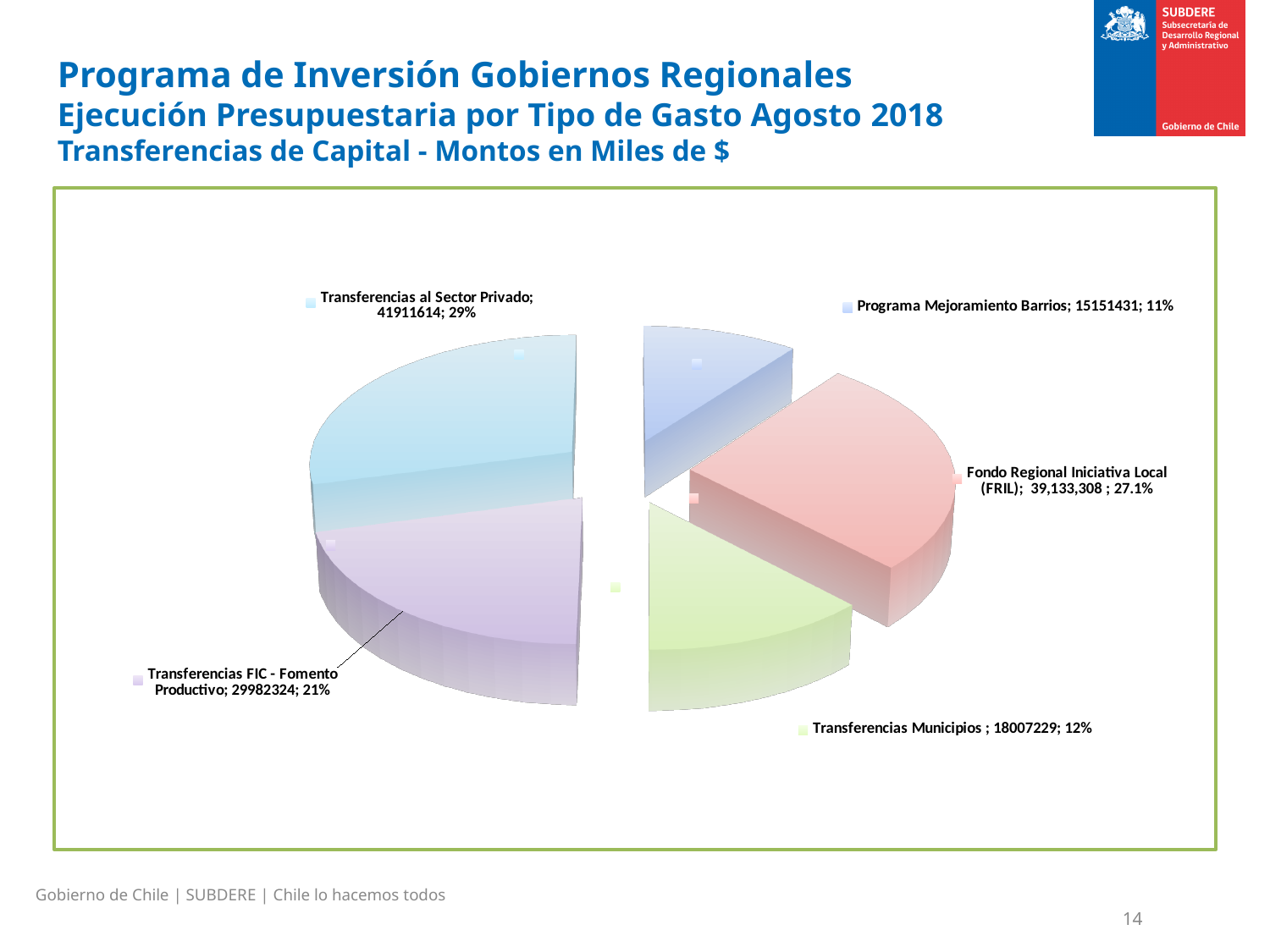
Which is larger, the value for Transferencias FIC - Fomento Productivo or the value for Transferencias Municipios? Transferencias FIC - Fomento Productivo What is the value shown for Transferencias al Sector Privado? 41911614 What is the value shown for Transferencias Municipios? 18007229 What is the difference in value between Transferencias Municipios and Programa Mejoramiento Barrios? 2855798 What percentage share does Transferencias FIC - Fomento Productivo have in the pie chart? 21% Which category has the largest slice of the pie chart? Transferencias al Sector Privado What kind of chart is shown on the slide? Pie chart What is the value shown for Fondo Regional Iniciativa Local (FRIL)? 39,133,308 Which category has the smallest slice of the pie chart? Programa Mejoramiento Barrios What percentage share does Fondo Regional Iniciativa Local (FRIL) have in the pie chart? 27.1% What percentage share does Programa Mejoramiento Barrios have in the pie chart? 11% How many slices does the pie chart have? 5